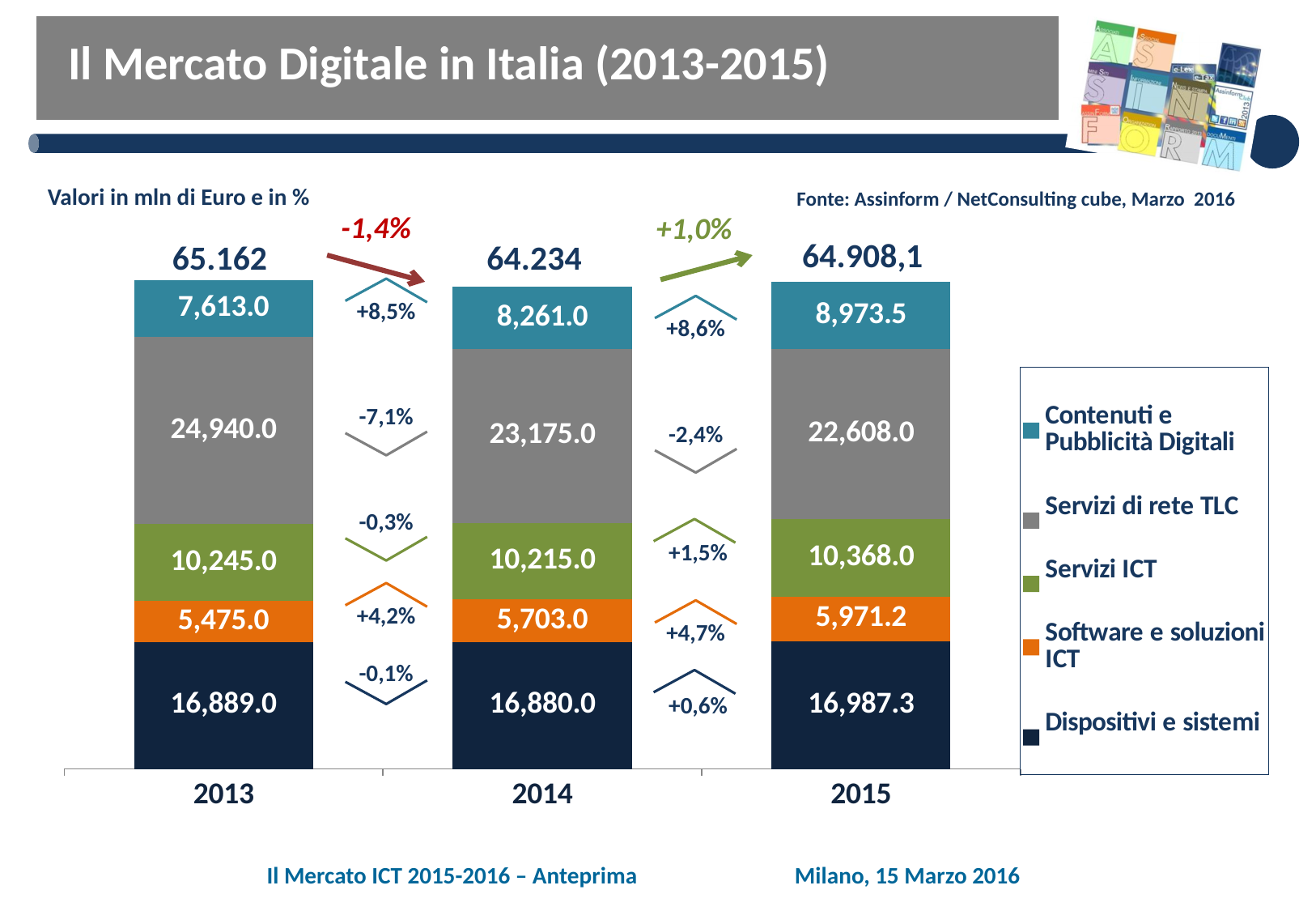
What kind of chart is shown on the slide? Stacked bar chart What is the value for Servizi di rete TLC in 2014? 23,175.0 How many years are shown on the x axis? 3 Does the Servizi di rete TLC value rise or fall from 2013 to 2015? Fall Is the Servizi di rete TLC value larger in 2013 or in 2015? 2013 How many series does the legend list? 5 What is the value for Contenuti e Pubblicità Digitali in 2013? 7,613.0 What is the difference between the Servizi ICT value in 2015 and in 2014? 153.0 What is the value for Dispositivi e sistemi in 2015? 16,987.3 What is the total of the 2014 stacked bar? 64.234 Which segment is the largest in the 2013 bar? Servizi di rete TLC Which segment is the smallest in the 2015 bar? Software e soluzioni ICT